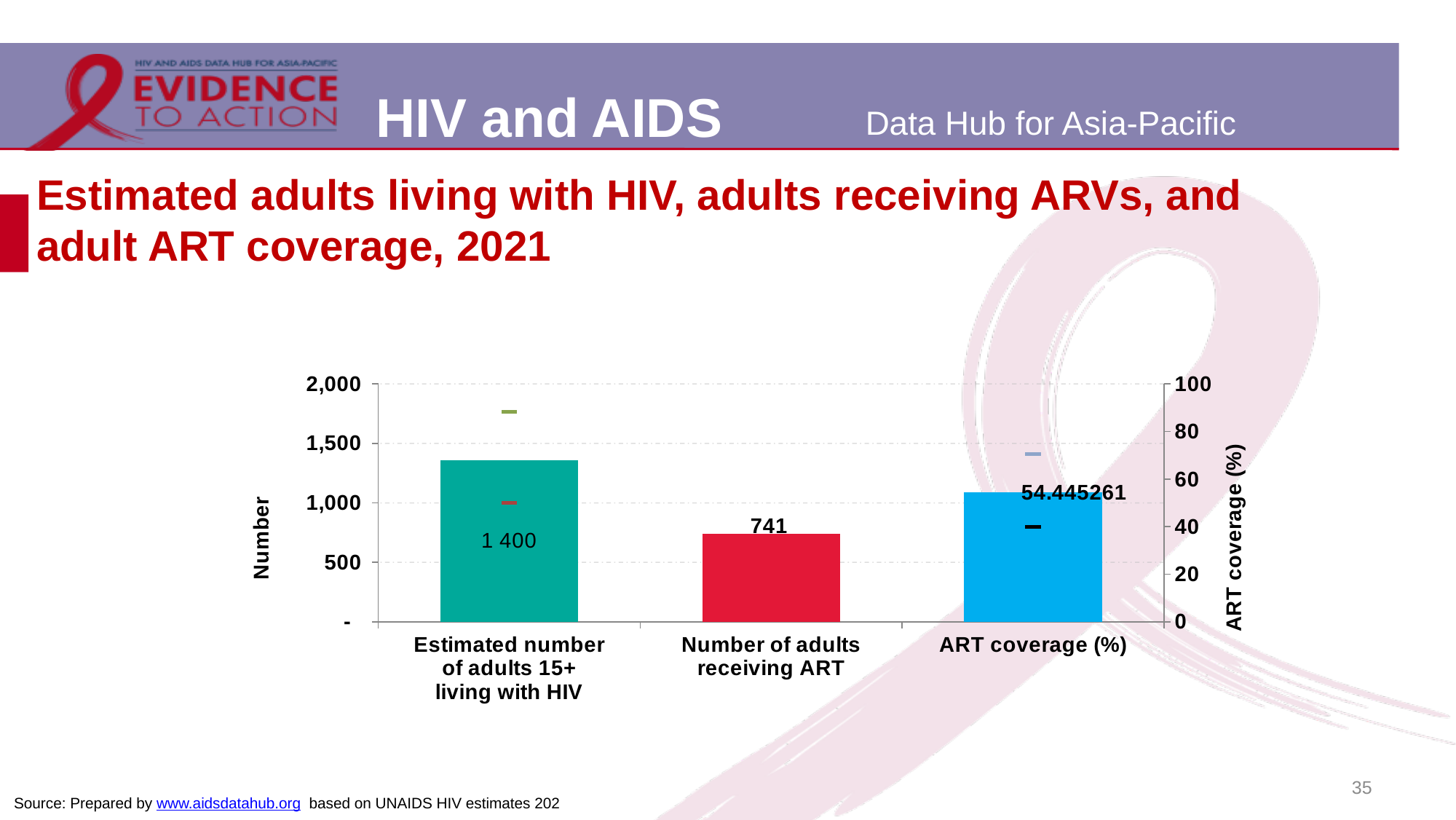
What is the value shown for ART coverage (%)? 54.445261 What is the title of the right vertical axis? ART coverage (%) Is the value for ART coverage (%) greater or less than 60 on the right axis? less What is the value shown for the Estimated number of adults 15+ living with HIV? 1 400 Which category has the tallest bar in the chart? Estimated number of adults 15+ living with HIV How many categories are shown on the x axis of the chart? 3 What is the difference between the Estimated number of adults 15+ living with HIV and the Number of adults receiving ART? 659 Which is larger: the Estimated number of adults 15+ living with HIV or the Number of adults receiving ART? Estimated number of adults 15+ living with HIV What is the value shown for the Number of adults receiving ART? 741 What is the title of the left vertical axis? Number What kind of chart is shown on the slide? bar chart Is the value for Number of adults receiving ART greater or less than 1,000 on the left axis? less